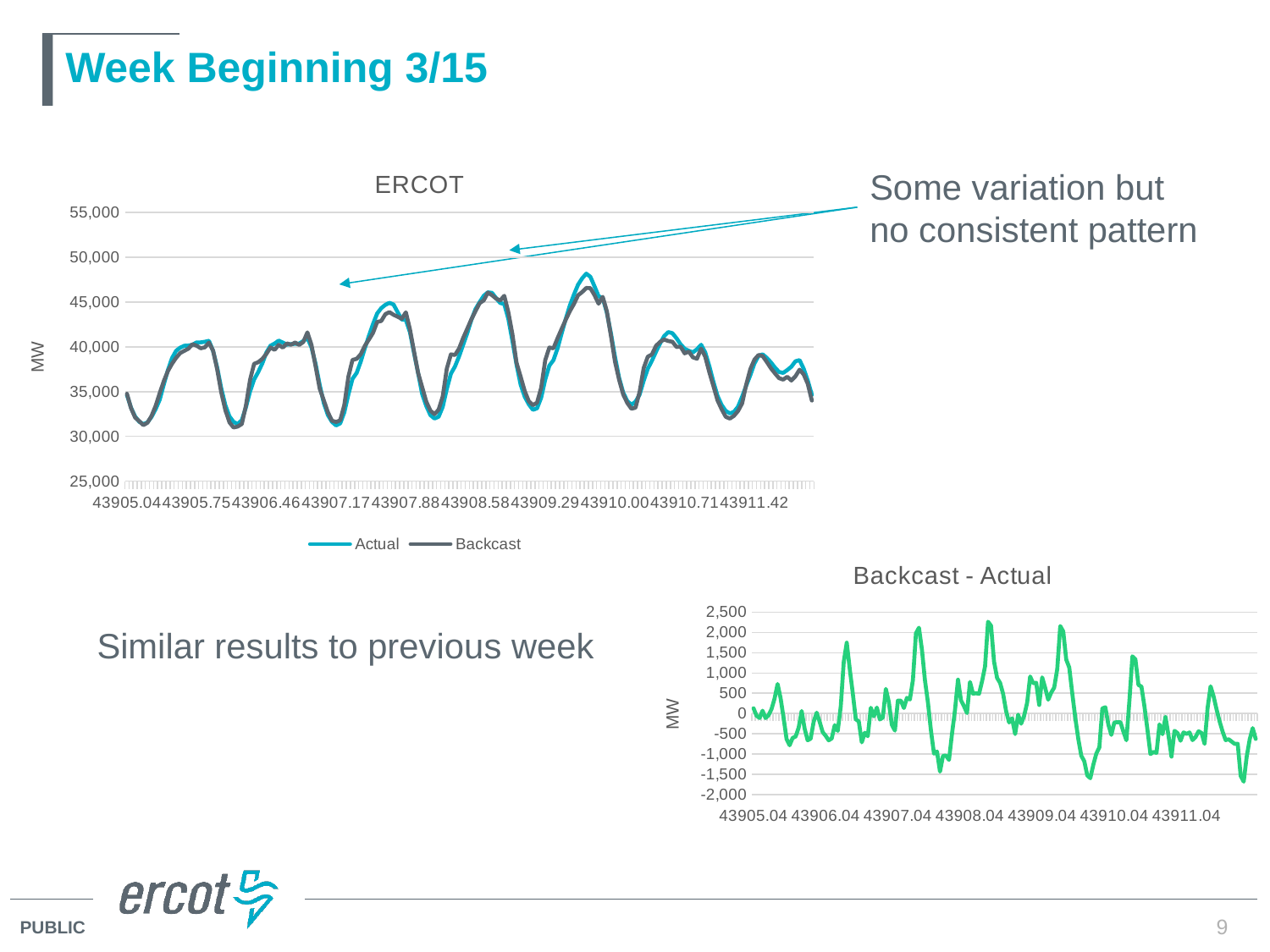
In the ERCOT chart, is the highest value of the Backcast series greater or less than 50,000? less How many series does the legend of the ERCOT chart list? 2 What is the title of the chart in the lower right of the slide? Backcast - Actual In the ERCOT chart, is the lowest value of the Actual series greater or less than 35,000? less What are the two series named in the legend of the ERCOT chart? Actual and Backcast What is the lowest tick value shown on the y-axis of the ERCOT chart? 25,000 In the ERCOT chart, is the highest value of the Actual series greater or less than 45,000? greater What is the highest tick value shown on the y-axis of the Backcast - Actual chart? 2,500 What type of chart is the ERCOT chart? line chart What is the y-axis label on the ERCOT chart? MW